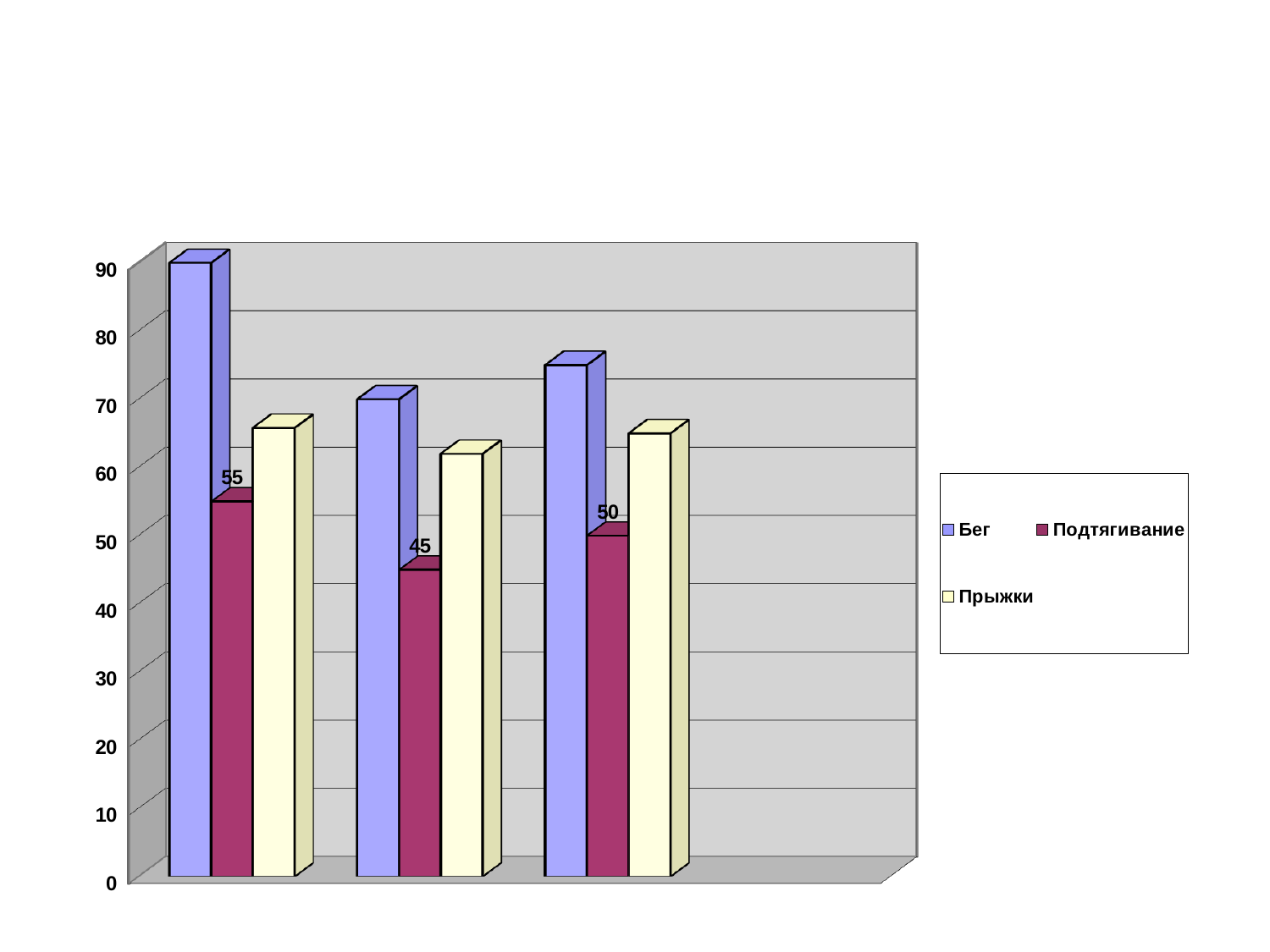
In which group of bars is the Подтягивание value highest? the first (leftmost) group What is the difference between the Подтягивание values in the first and second groups? 10 What kind of chart is shown on the slide? bar chart What is the value of Подтягивание in the third (rightmost) group of bars? 50 Is the value for Бег in the first (leftmost) group greater or less than 80? greater How many groups of bars are plotted on the chart? 3 How many series does the legend list? 3 Which series is shown in yellow in the legend? Прыжки What is the value of Подтягивание in the second (middle) group of bars? 45 In the first (leftmost) group, which is larger: Бег or Подтягивание? Бег What is the value of Подтягивание in the first (leftmost) group of bars? 55 In which group of bars is the Подтягивание value lowest? the second (middle) group